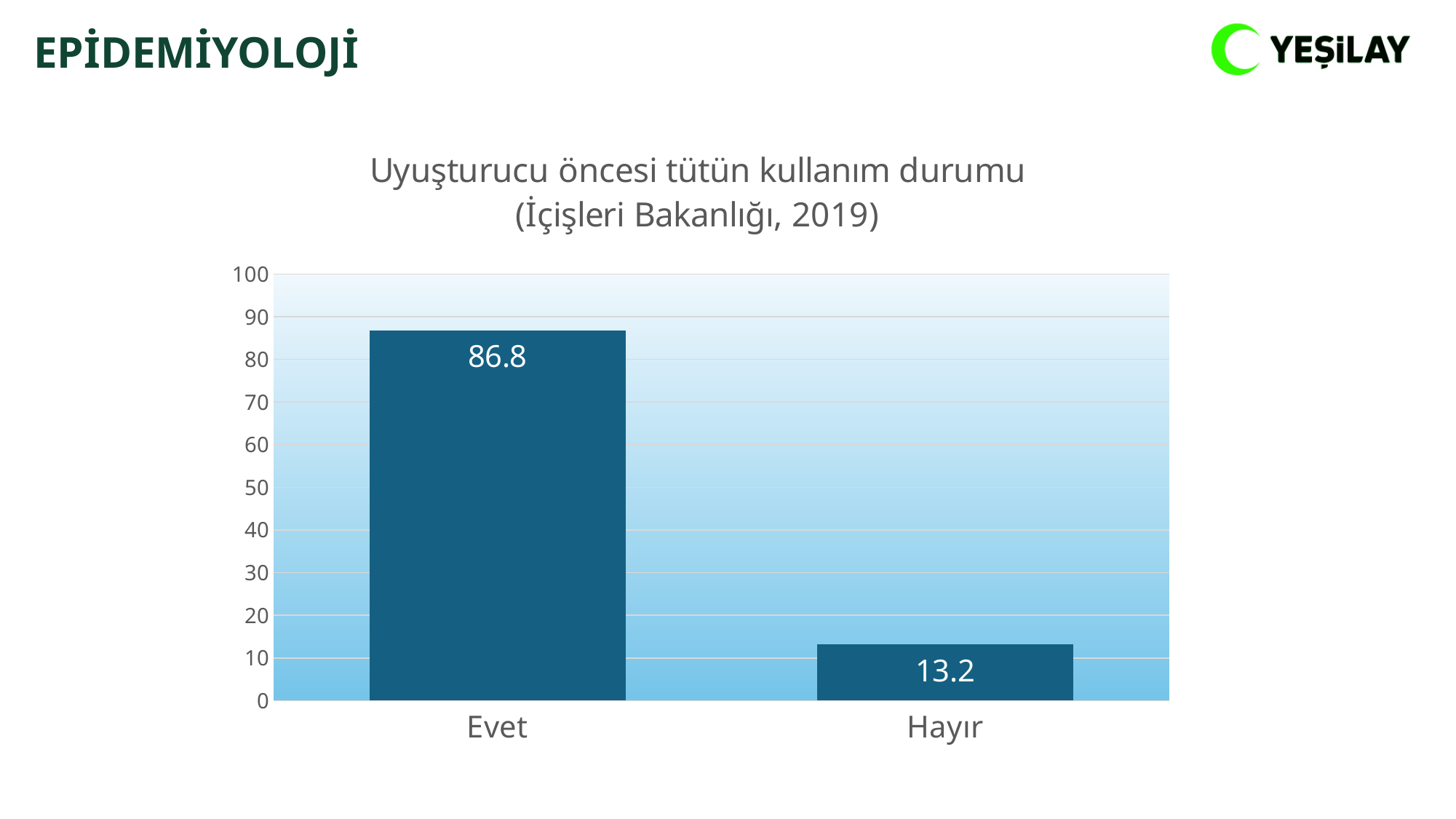
Which is larger, the value for Evet or the value for Hayır? Evet Is the value for Evet greater or less than 80? greater What kind of chart is shown on the slide? bar chart What is the value for Evet? 86.8 Is the value for Hayır greater or less than 20? less Which category has the highest value? Evet Which category has the lowest value? Hayır What is the difference between the values for Evet and Hayır? 73.6 What is the maximum value shown on the y axis? 100 What is the title of the chart? Uyuşturucu öncesi tütün kullanım durumu (İçişleri Bakanlığı, 2019) What is the value for Hayır? 13.2 How many categories are shown on the x axis? 2